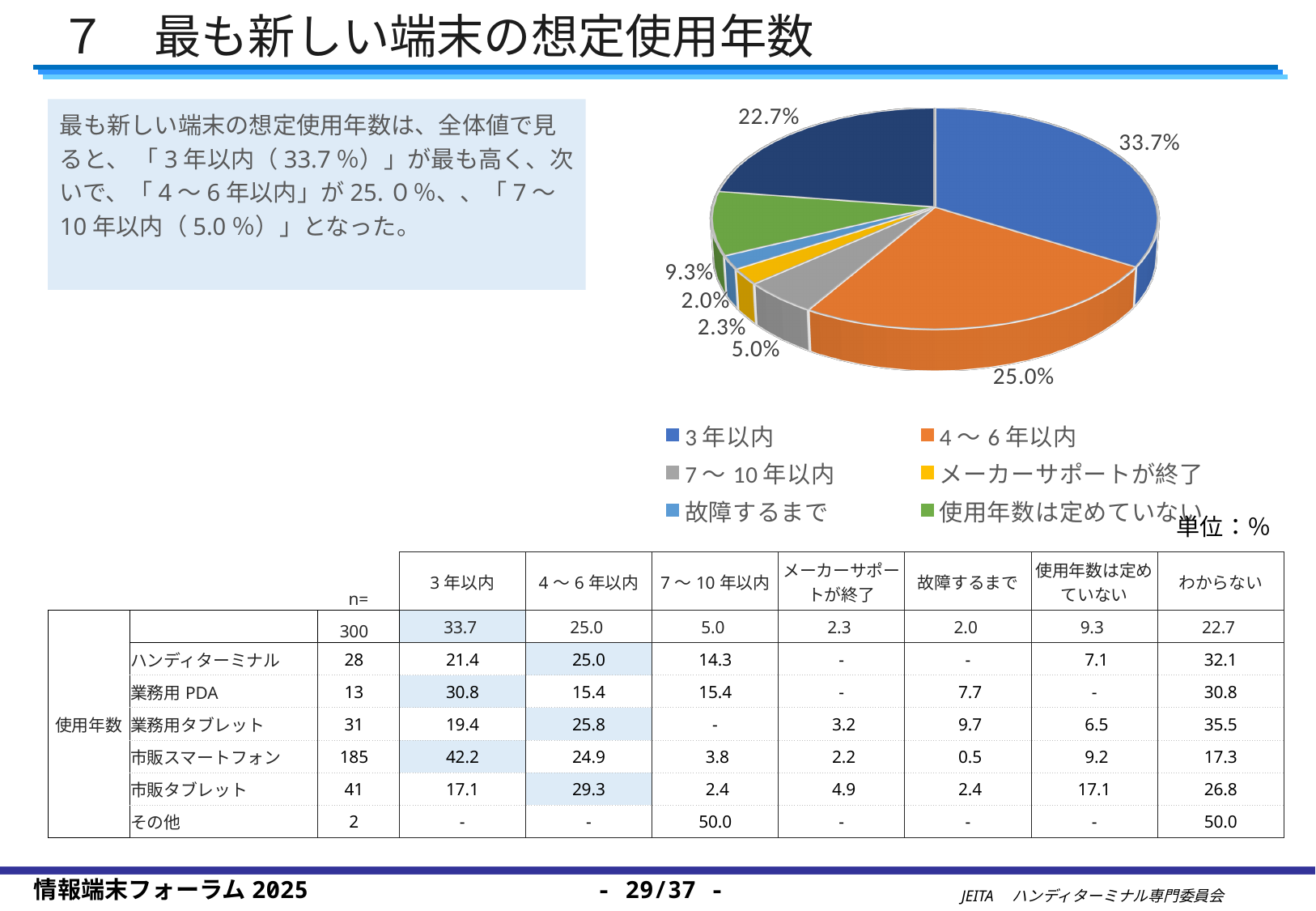
What colour is the 4～6年以内 slice in the pie chart? Orange What is the difference in percentage points between the 3年以内 slice and the 4～6年以内 slice? 8.7 percentage points What kind of chart is shown on the slide? Pie chart How many entries does the pie chart's legend list? 6 Which slice is larger in the pie chart: 使用年数は定めていない or 7～10年以内? 使用年数は定めていない Which category has the largest slice in the pie chart? 3年以内 What percentage does the pie chart show for 使用年数は定めていない? 9.3% What percentage does the pie chart show for 4～6年以内? 25.0% Which legend category has the smallest slice in the pie chart? 故障するまで What percentage does the pie chart show for 3年以内? 33.7% How many slices does the pie chart have? 7 What percentage does the pie chart show for 7～10年以内? 5.0%